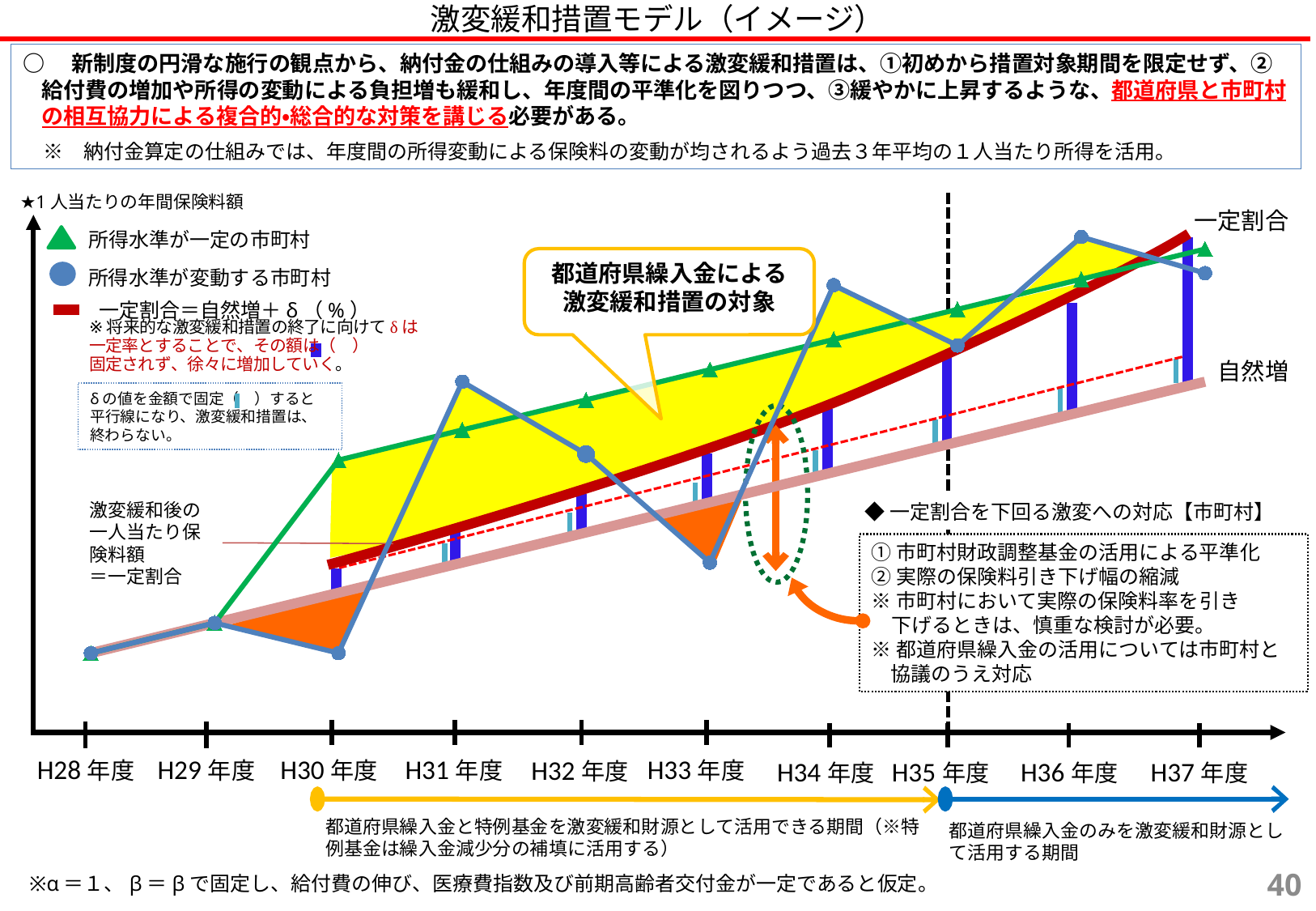
Does the 一定割合 line rise or fall from H28年度 to H37年度? rise In H31年度, which is higher: 所得水準が一定の市町村 or 所得水準が変動する市町村? 所得水準が変動する市町村 What kind of chart is shown on the slide? line chart What is the title of the chart on the slide? 激変緩和措置モデル（イメージ） In which fiscal year is the 所得水準が一定の市町村 series at its lowest? H28年度 In which fiscal year does the 所得水準が変動する市町村 series reach its highest point? H36年度 How many fiscal years are labelled along the x axis of the chart? 10 How many series does the chart legend list? 3 In H33年度, which is higher: 所得水準が一定の市町村 or 所得水準が変動する市町村? 所得水準が一定の市町村 Which marker shape represents 所得水準が一定の市町村 in the legend? triangle In which fiscal year does the 所得水準が一定の市町村 series reach its highest point? H37年度 Does the 自然増 line rise or fall along the x axis? rise